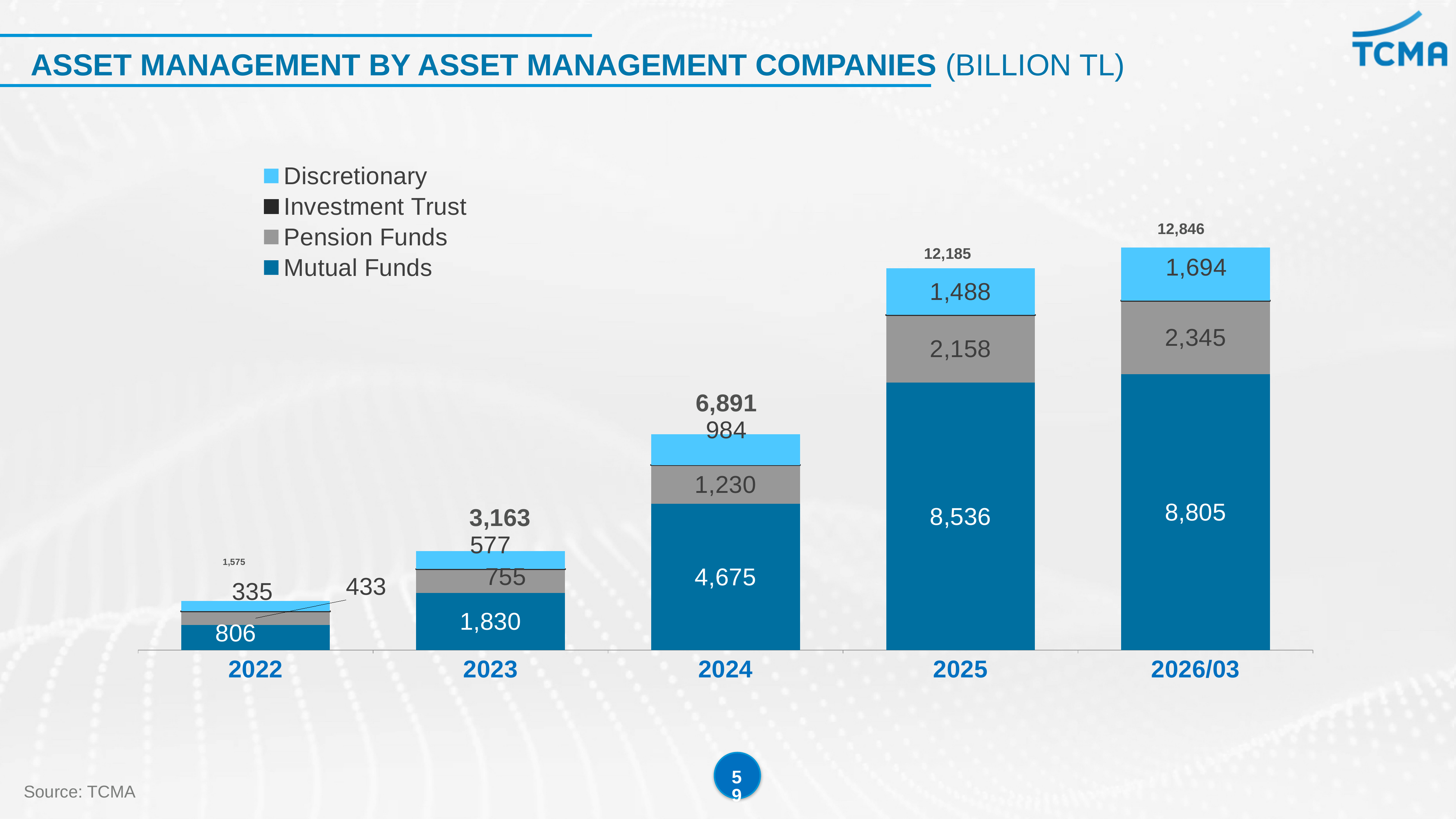
What is the Mutual Funds value for 2025? 8,536 What is the Discretionary value for 2023? 577 What is the total value printed above the 2026/03 bar? 12,846 How many years are shown on the x axis? 5 Do the total values rise or fall from 2022 to 2026/03? Rise Which year has the lowest total value? 2022 Which year has the highest Mutual Funds value? 2026/03 What is the difference between the Mutual Funds values for 2026/03 and 2025? 269 How many series does the legend list? 4 What kind of chart is shown on the slide? Stacked bar chart What is the Pension Funds value for 2024? 1,230 Which is larger, the Pension Funds value for 2025 or the Discretionary value for 2026/03? Pension Funds value for 2025